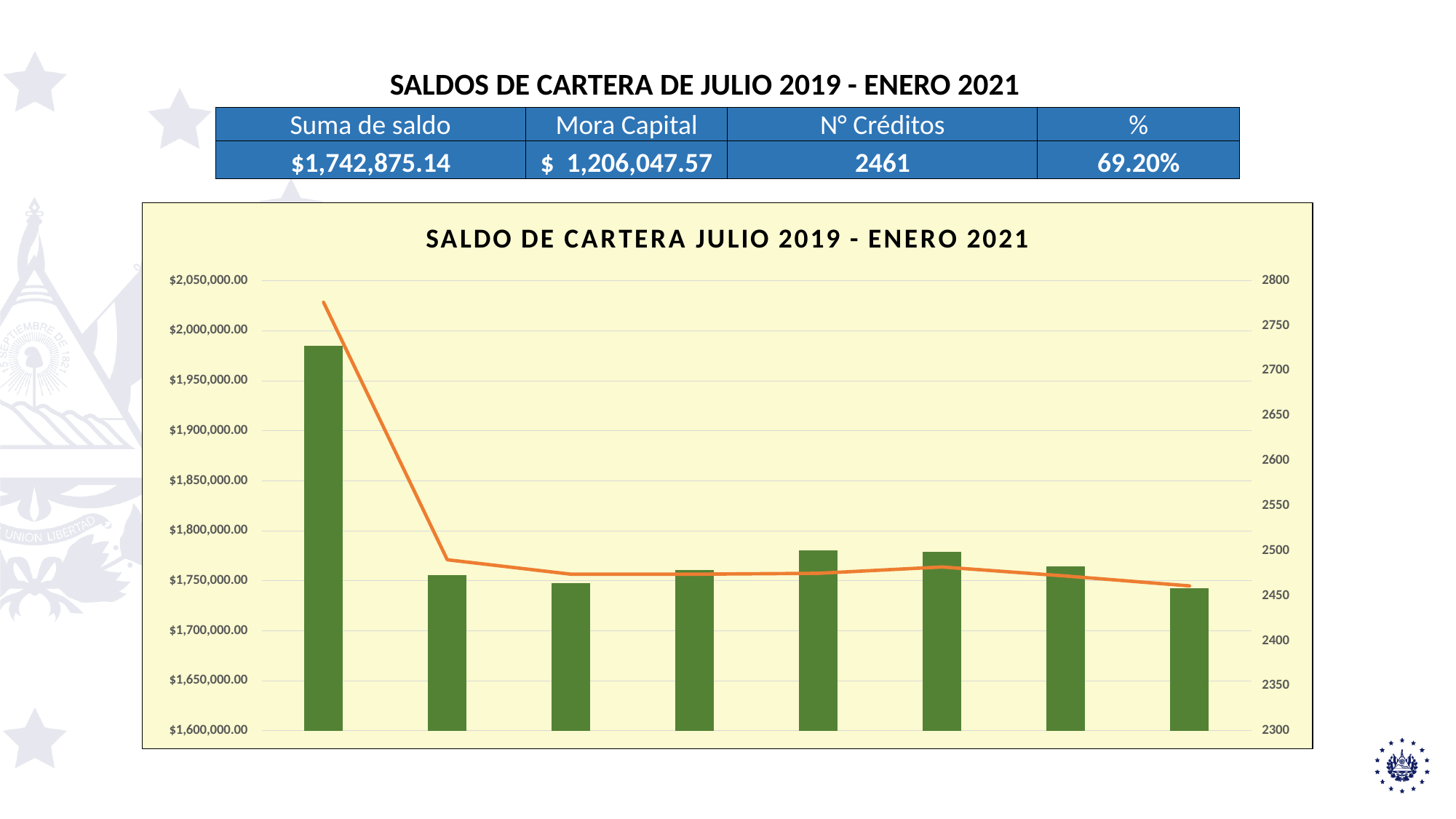
How many bars are plotted in the chart? 8 Which is larger, the first bar or the fifth bar? The first bar Is the value of the first bar greater or less than $1,950,000.00? greater What kind of chart is shown on the slide? A bar chart combined with a line On the right axis, is the first point of the orange line greater or less than 2750? greater What colour are the bars in the chart? Green Which bar is the tallest in the chart? The first (leftmost) bar On the right axis, is the last point of the orange line greater or less than 2500? less Does the orange line generally rise or fall from left to right? Fall What is the title of the chart? SALDO DE CARTERA JULIO 2019 - ENERO 2021